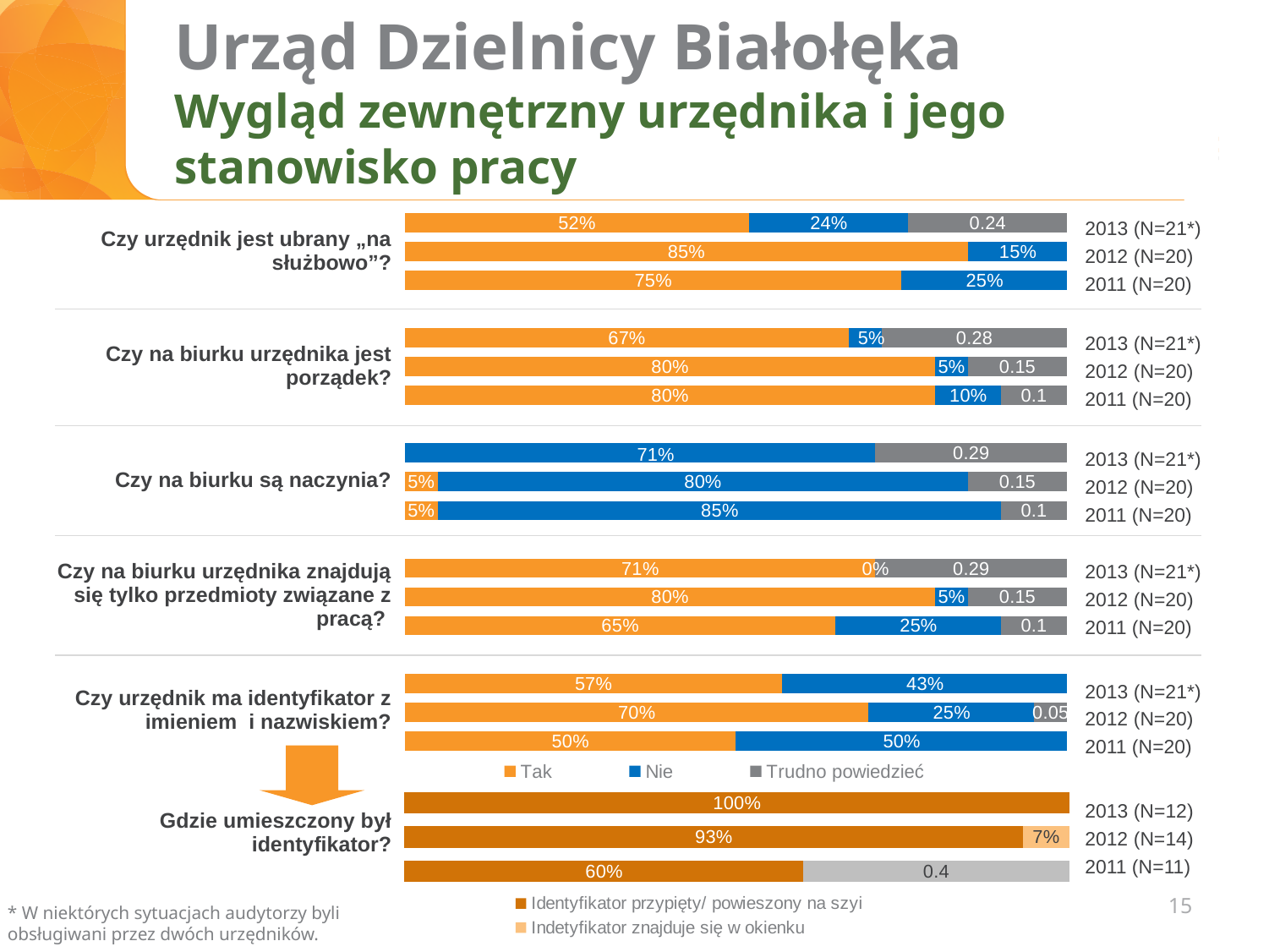
In the chart for "Gdzie umieszczony był identyfikator?", what is the value for "Identyfikator przypięty/ powieszony na szyi" in 2012 (N=14)? 93% What type of chart is used for "Czy urzędnik jest ubrany „na służbowo”?"? Stacked bar chart In the chart for "Czy na biurku są naczynia?", what is the "Nie" value for 2011 (N=20)? 85% In the chart for "Czy urzędnik ma identyfikator z imieniem i nazwiskiem?", which year has the lowest "Tak" value? 2011 (N=20) In the chart for "Czy urzędnik jest ubrany „na służbowo”?", which year has the highest "Tak" value? 2012 (N=20) In the chart for "Czy na biurku są naczynia?", which is larger: the "Nie" value for 2012 (N=20) or for 2013 (N=21*)? 2012 (N=20) How many series does the legend of the chart for "Gdzie umieszczony był identyfikator?" list? 2 In the chart for "Czy urzędnik ma identyfikator z imieniem i nazwiskiem?", what is the "Nie" value for 2013 (N=21*)? 43% In the chart for "Czy na biurku urzędnika jest porządek?", what is the "Trudno powiedzieć" value for 2013 (N=21*)? 0.28 In the chart for "Czy na biurku urzędnika jest porządek?", what is the "Nie" value for 2011 (N=20)? 10% In the chart for "Czy urzędnik jest ubrany „na służbowo”?", what is the "Tak" value for 2012 (N=20)? 85% In the chart for "Czy na biurku urzędnika znajdują się tylko przedmioty związane z pracą?", what is the difference between the "Tak" values for 2012 (N=20) and 2011 (N=20)? 15%